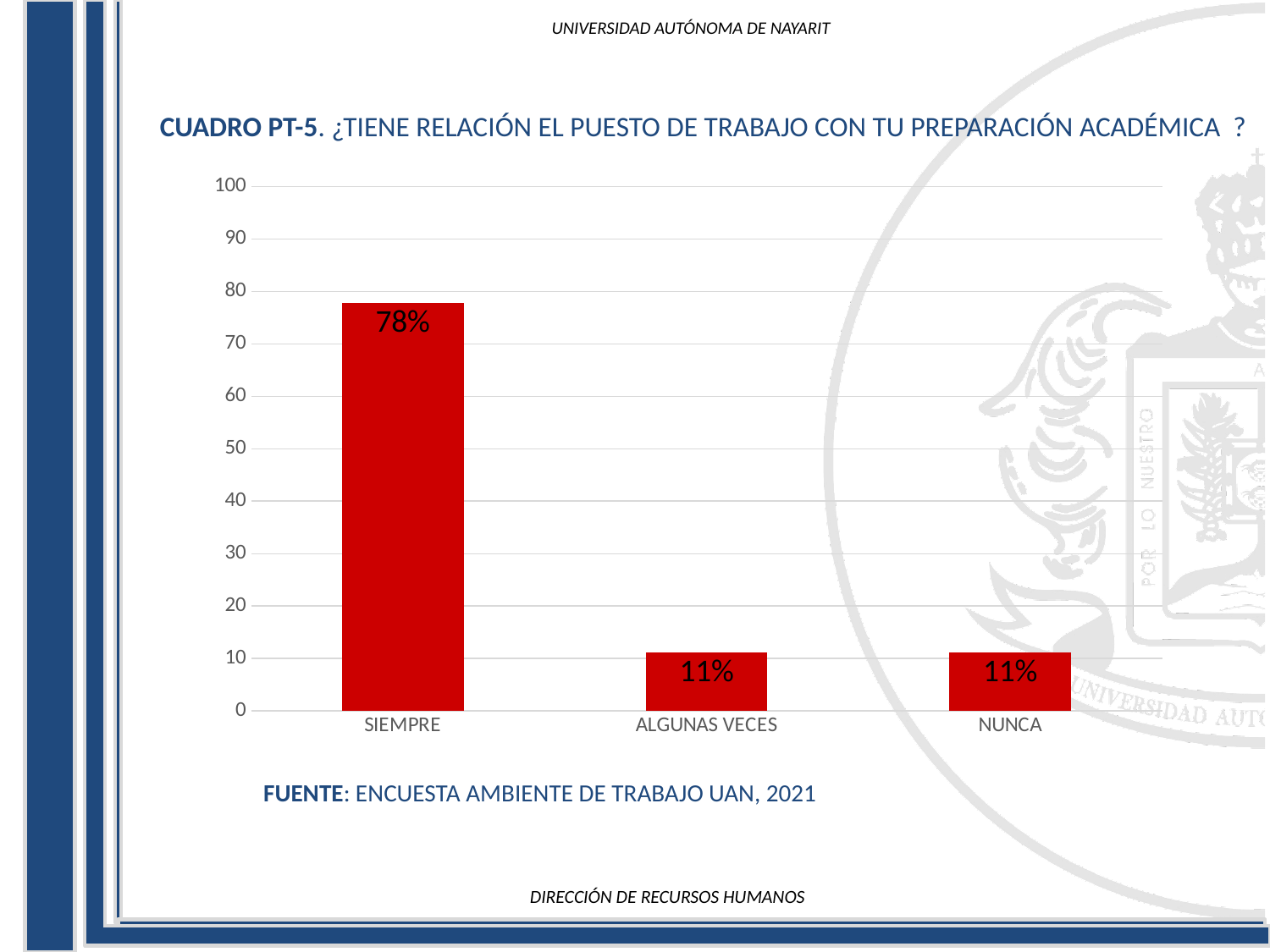
What is the value for ALGUNAS VECES? 11% Is the value for SIEMPRE greater or less than 70? greater What is the difference between the values for SIEMPRE and ALGUNAS VECES? 67% What is the value for SIEMPRE? 78% What kind of chart is shown on the slide? bar chart Which category has the highest value? SIEMPRE What is the value for NUNCA? 11% What is the source cited below the chart? ENCUESTA AMBIENTE DE TRABAJO UAN, 2021 Which is larger, the value for SIEMPRE or the value for ALGUNAS VECES? SIEMPRE How many categories are shown on the x axis? 3 What is the difference between the values for SIEMPRE and NUNCA? 67% Is the value for NUNCA greater or less than 20? less